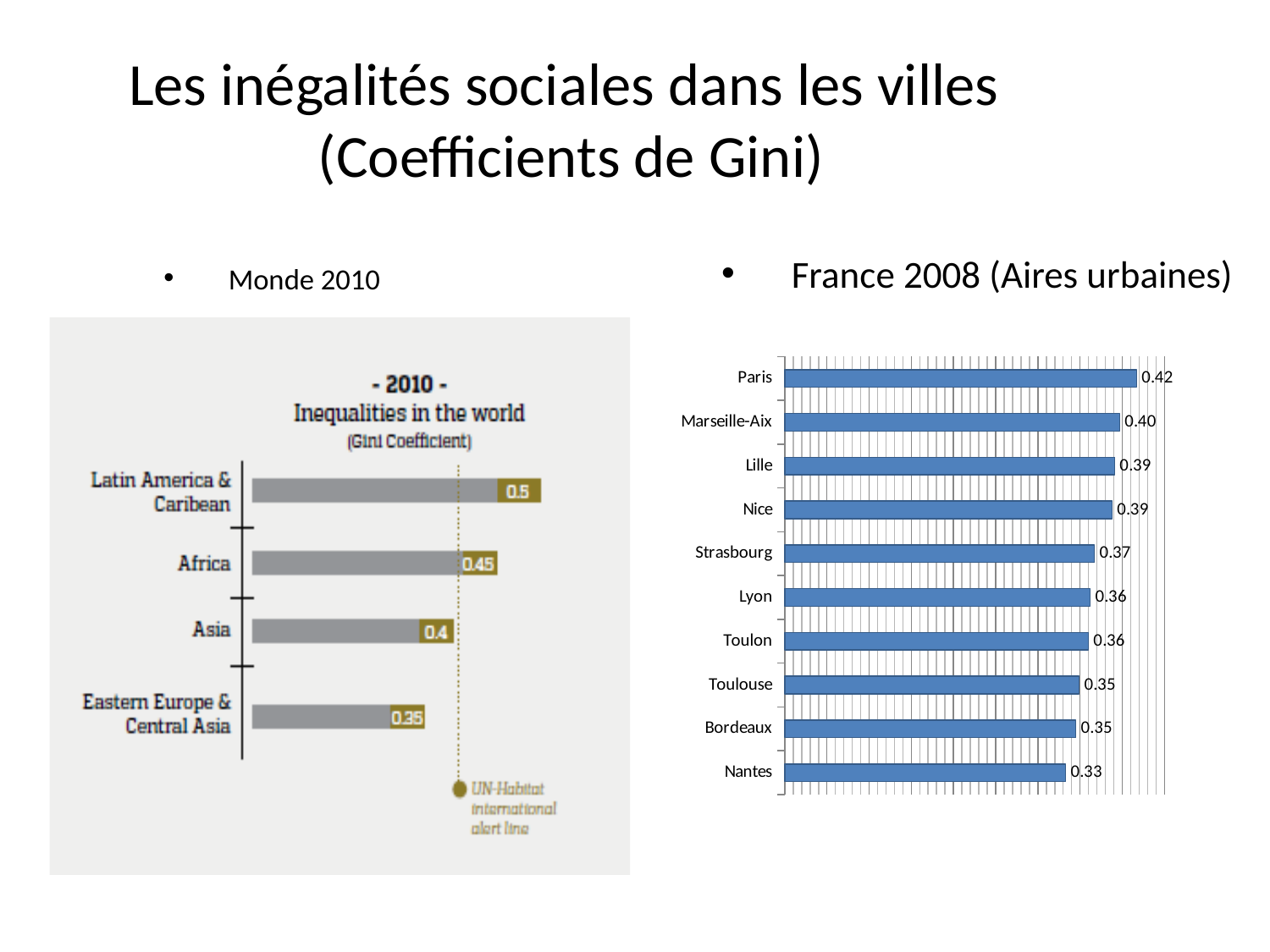
In the Monde 2010 chart (Inequalities in the world), which region has the highest Gini coefficient? Latin America & Caribean In the Monde 2010 chart (Inequalities in the world), what is the difference between the values for Latin America & Caribean and Eastern Europe & Central Asia? 0.15 In the Monde 2010 chart (Inequalities in the world), what is the Gini coefficient for Africa? 0.45 In the France 2008 (Aires urbaines) chart, what is the Gini coefficient for Paris? 0.42 In the France 2008 (Aires urbaines) chart, what is the value for Strasbourg? 0.37 In the France 2008 (Aires urbaines) chart, what is the difference between the values for Paris and Nantes? 0.09 In the France 2008 (Aires urbaines) chart, how many urban areas are shown? 10 In the Monde 2010 chart (Inequalities in the world), how many regions are shown? 4 In the France 2008 (Aires urbaines) chart, which urban area has the highest value? Paris In the France 2008 (Aires urbaines) chart, which is larger, the value for Marseille-Aix or the value for Lyon? Marseille-Aix What kind of chart is the France 2008 (Aires urbaines) chart? Bar chart In the France 2008 (Aires urbaines) chart, which urban area has the lowest value? Nantes